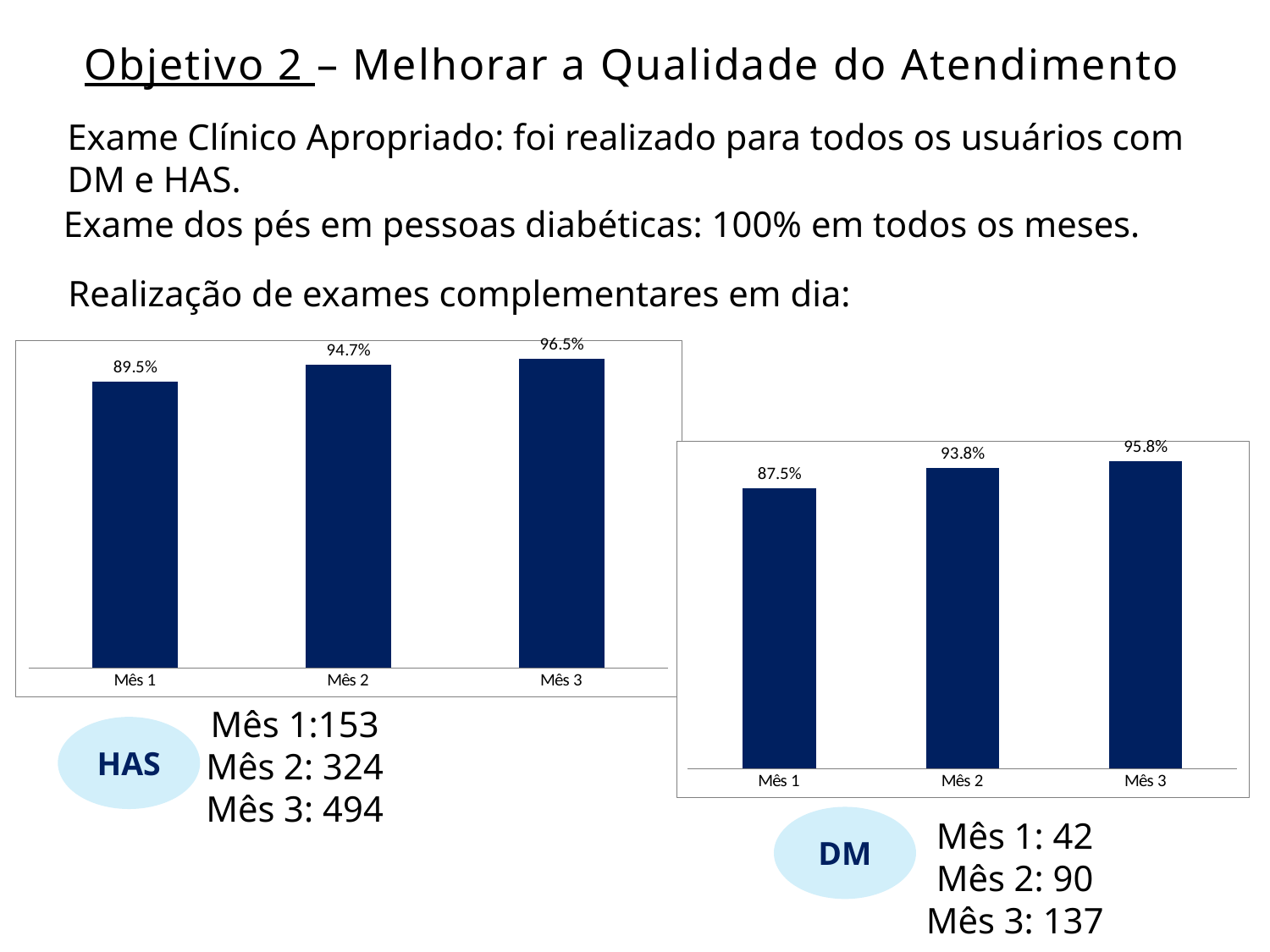
How many bars are in the right chart (DM)? 3 In the left chart (HAS), which month has the highest value? Mês 3 Which is larger: Mês 3 in the left chart (HAS) or Mês 3 in the right chart (DM)? Mês 3 in the left chart (HAS) In the right chart (DM), which month has the lowest value? Mês 1 In the right chart (DM), what is the value for Mês 2? 93.8% In the left chart (HAS), what is the difference between Mês 2 and Mês 1? 5.2% What type of chart is the left chart (HAS)? Bar chart In the right chart (DM), what is the difference between Mês 3 and Mês 1? 8.3% In the right chart (DM), what is the value for Mês 1? 87.5% In the right chart (DM), do the values rise or fall from Mês 1 to Mês 3? Rise In the left chart (HAS), what is the value for Mês 1? 89.5% In the left chart (HAS), what is the value for Mês 3? 96.5%